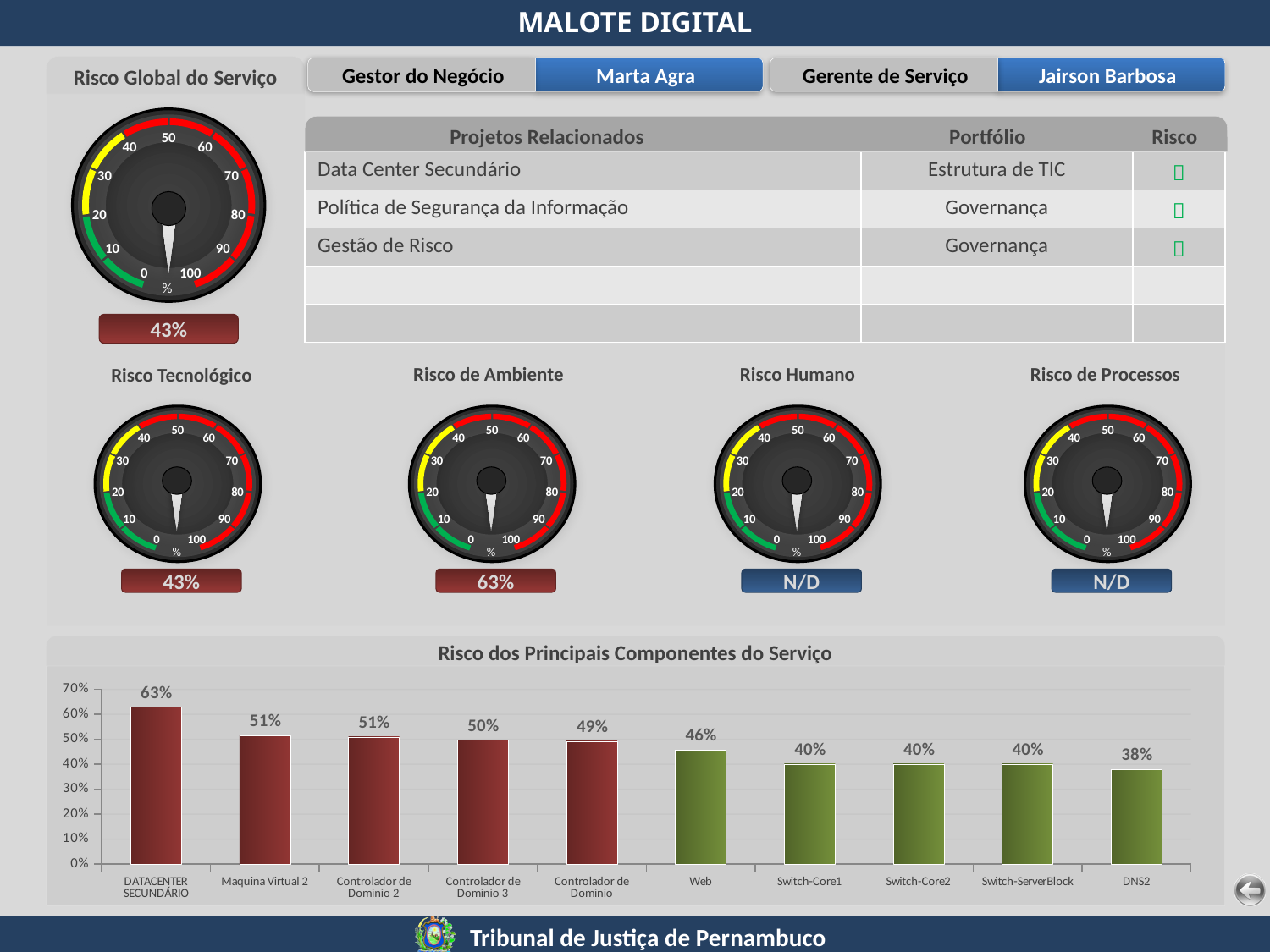
In the 'Risco dos Principais Componentes do Serviço' chart, what is the value for Web? 46% What value is shown below the 'Risco de Ambiente' gauge? 63% In the 'Risco dos Principais Componentes do Serviço' chart, what is the value for DATACENTER SECUNDÁRIO? 63% In the 'Risco dos Principais Componentes do Serviço' chart, what is the value for DNS2? 38% In the 'Risco dos Principais Componentes do Serviço' chart, which is larger: Web or Switch-Core1? Web What value is shown below the 'Risco Global do Serviço' gauge? 43% In the 'Risco dos Principais Componentes do Serviço' chart, do the values rise or fall from left to right? Fall What kind of chart is 'Risco dos Principais Componentes do Serviço'? Bar chart In the 'Risco dos Principais Componentes do Serviço' chart, what is the difference between DATACENTER SECUNDÁRIO and DNS2? 25% In the 'Risco dos Principais Componentes do Serviço' chart, how many components are plotted? 10 In the 'Risco dos Principais Componentes do Serviço' chart, which component has the highest value? DATACENTER SECUNDÁRIO In the 'Risco dos Principais Componentes do Serviço' chart, which component has the lowest value? DNS2